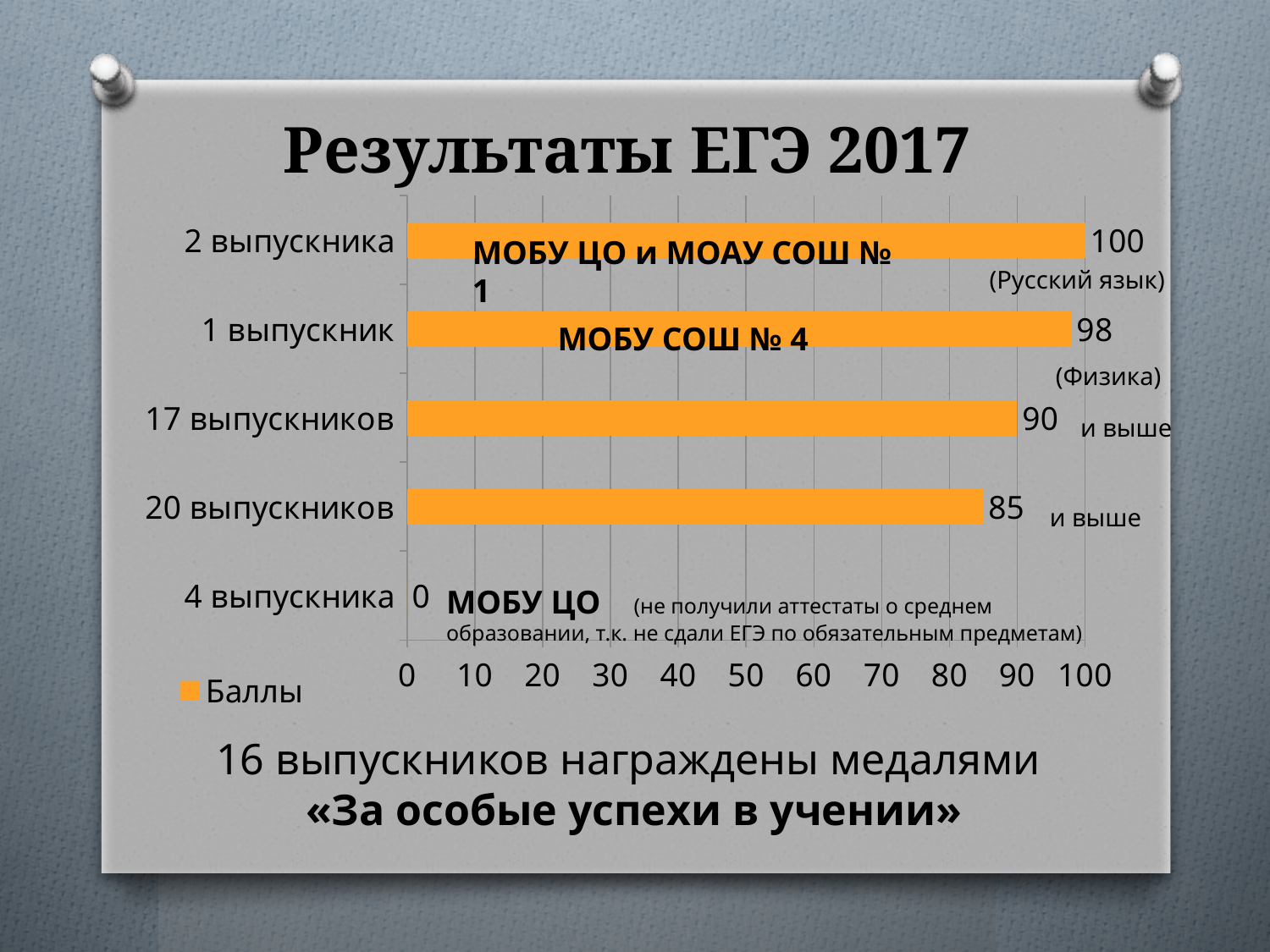
What value is shown for the category "17 выпускников"? 90 What kind of chart is shown on the slide? bar chart What value is shown for the category "4 выпускника"? 0 How many categories are shown on the chart? 5 What is the difference between the values for "2 выпускника" and "20 выпускников"? 15 Which category has the lowest value? 4 выпускника What value is shown for the category "20 выпускников"? 85 What value is shown for the category "2 выпускника"? 100 What value is shown for the category "1 выпускник"? 98 Which category has the highest value? 2 выпускника Which is larger, the value for "1 выпускник" or the value for "17 выпускников"? 1 выпускник How many series does the legend list? 1